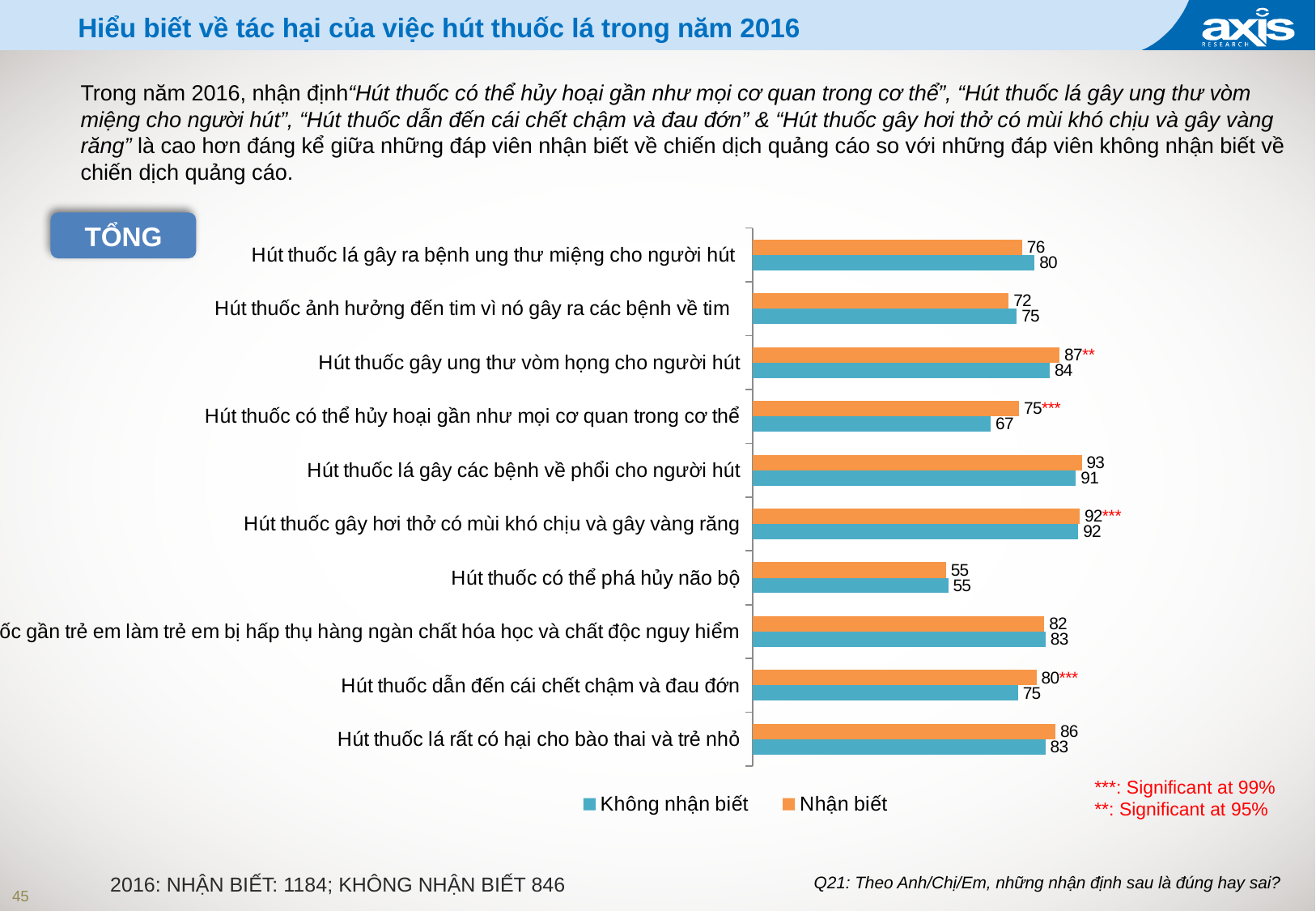
Which statement has the lowest value for "Nhận biết"? Hút thuốc có thể phá hủy não bộ What is the value for "Nhận biết" for "Hút thuốc gây ung thư vòm họng cho người hút"? 87 How many series does the legend list? 2 How many categories (statements) are plotted in the chart? 10 Which legend entry is shown in orange? Nhận biết Which statement has the highest value for "Không nhận biết"? Hút thuốc gây hơi thở có mùi khó chịu và gây vàng răng What kind of chart is shown on the slide? bar chart What is the value for "Nhận biết" for "Hút thuốc lá gây các bệnh về phổi cho người hút"? 93 What is the value for "Không nhận biết" for "Hút thuốc có thể hủy hoại gần như mọi cơ quan trong cơ thể"? 67 What is the difference between "Nhận biết" and "Không nhận biết" for "Hút thuốc có thể hủy hoại gần như mọi cơ quan trong cơ thể"? 8 For "Hút thuốc lá gây ra bệnh ung thư miệng cho người hút", which is larger: "Nhận biết" or "Không nhận biết"? Không nhận biết What is the difference between "Nhận biết" and "Không nhận biết" for "Hút thuốc dẫn đến cái chết chậm và đau đớn"? 5